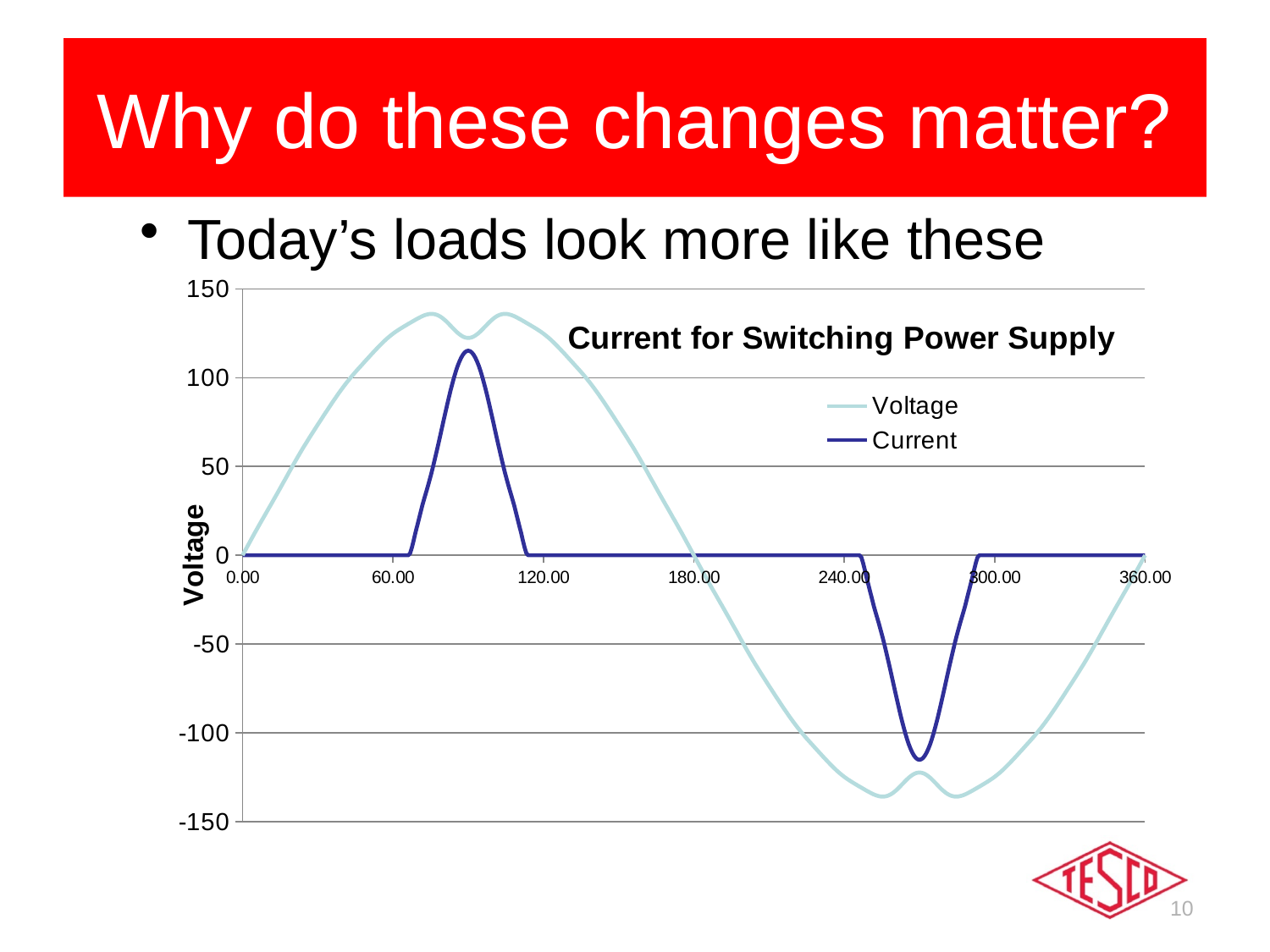
What is the Voltage value at x = 180.00? 0 Which series reaches a higher maximum value, Voltage or Current? Voltage Is the Voltage value at x = 240.00 greater or less than -100? less What is the title of the chart? Current for Switching Power Supply Is the peak value of the Voltage series greater or less than 100? greater Is the peak value of the Current series greater or less than 150? less What are the two series named in the chart legend? Voltage and Current How many tick labels are shown on the x axis? 7 What is the Current value at x = 0.00? 0 How many series does the chart legend list? 2 What kind of chart is shown on the slide? line chart